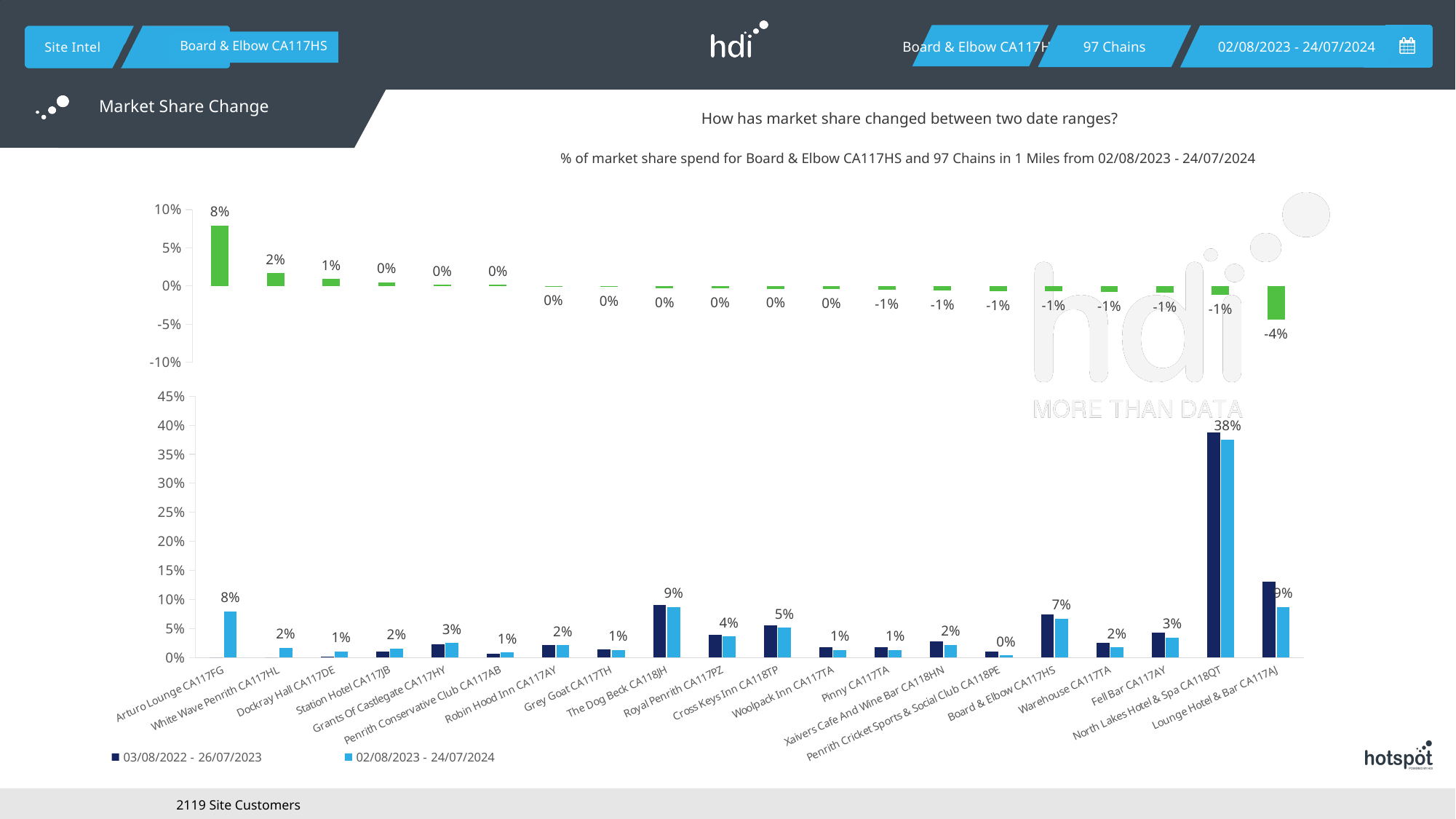
How many categories are shown along the x axis of the bottom chart? 20 In the bottom chart, for Lounge Hotel & Bar CA117AJ, which series has the larger value: 03/08/2022 - 26/07/2023 or 02/08/2023 - 24/07/2024? 03/08/2022 - 26/07/2023 In the top chart (market share change), what is the value of the first (leftmost) bar? 8% What are the two legend entries of the bottom chart? 03/08/2022 - 26/07/2023 and 02/08/2023 - 24/07/2024 How many series does the legend of the bottom chart list? 2 In the bottom chart, what is the value for Arturo Lounge CA117FG in the 02/08/2023 - 24/07/2024 series? 8% What kind of chart is the bottom chart on the slide? bar chart In the bottom chart, is the value for Lounge Hotel & Bar CA117AJ in the 03/08/2022 - 26/07/2023 series greater or less than 10%? greater In the bottom chart, what data label is shown for The Dog Beck CA118JH? 9% In the bottom chart, what data label is shown for North Lakes Hotel & Spa CA118QT? 38% In the top chart (market share change), what is the value of the last (rightmost) bar? -4% In the bottom chart, which category has the highest market share? North Lakes Hotel & Spa CA118QT